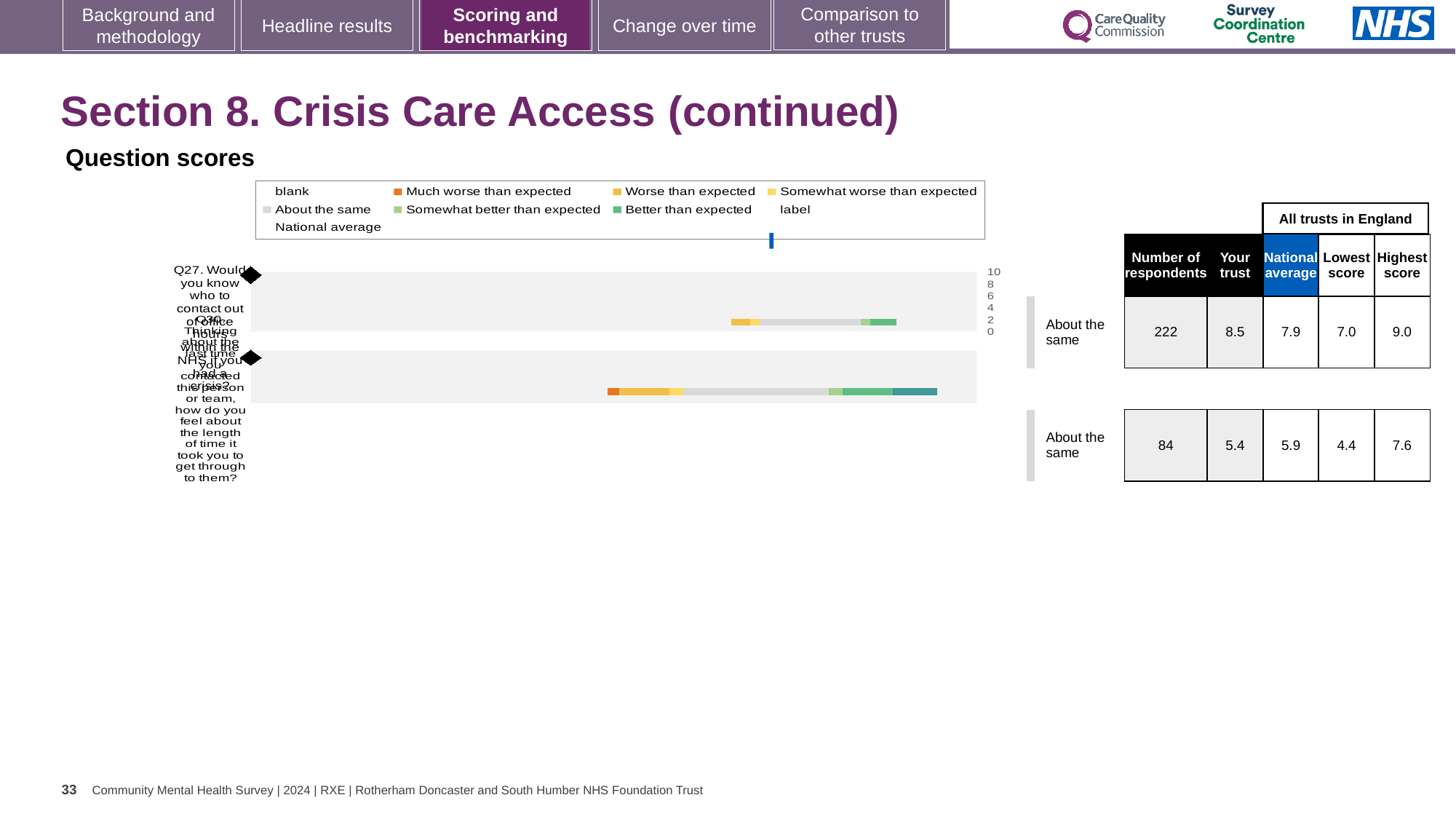
What is the difference between the national average and the 'Your trust' score for Q30? 0.5 How many questions are plotted in the question scores chart? 2 For Q30, which is larger: the 'Your trust' score or the national average? National average What is the 'Your trust' score for Q27? 8.5 What kind of chart is used to show the question scores on this slide? bar chart What is the national average score for Q30? 5.9 Which question has the higher 'Your trust' score, Q27 or Q30? Q27 What is the difference between the highest score and the lowest score for Q27? 2.0 What is the highest score among all trusts in England for Q30? 7.6 How many respondents answered Q27? 222 For Q27, which is larger: the 'Your trust' score or the national average? Your trust What benchmark category is shown for Q30? About the same